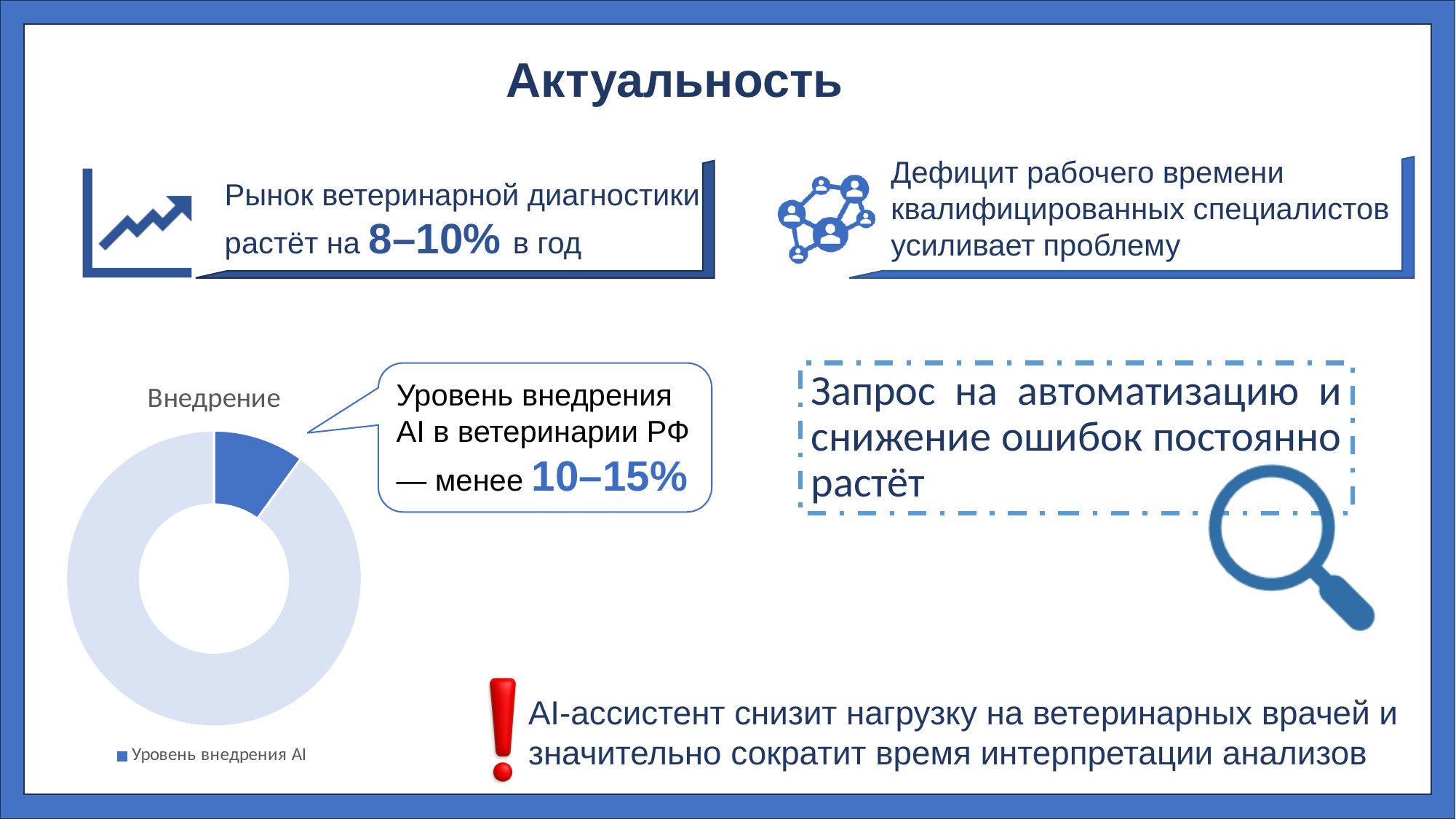
How many slices does the doughnut chart have? 2 What kind of chart is shown on the slide? doughnut chart What is the title of the chart on the slide? Внедрение Is the dark blue slice of the doughnut chart the smallest slice? yes How many entries does the chart's legend list? 1 Which slice of the doughnut chart is larger, the dark blue slice or the light blue slice? the light blue slice What is the legend entry of the chart? Уровень внедрения AI